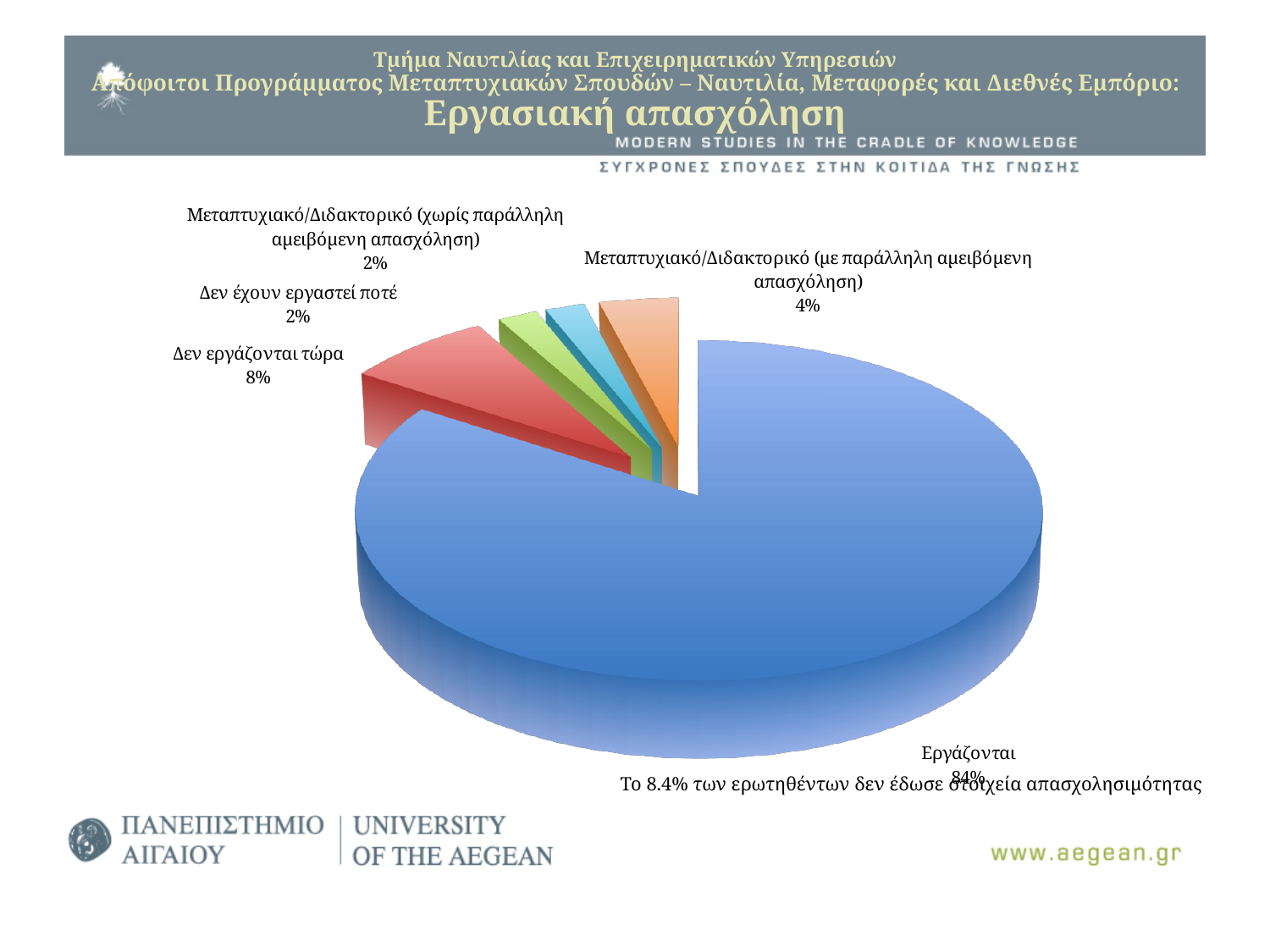
What is the difference in percentage points between "Μεταπτυχιακό/Διδακτορικό (με παράλληλη αμειβόμενη απασχόληση)" and "Δεν έχουν εργαστεί ποτέ"? 2 What colour is the slice for "Εργάζονται"? Blue What percentage of graduates are shown as "Εργάζονται"? 84% How many slices does the pie chart have? 5 Which category has the largest share of the pie? Εργάζονται Which is larger: "Δεν εργάζονται τώρα" or "Μεταπτυχιακό/Διδακτορικό (με παράλληλη αμειβόμενη απασχόληση)"? Δεν εργάζονται τώρα What is the value for "Δεν έχουν εργαστεί ποτέ"? 2% What is the difference in percentage points between "Εργάζονται" and "Δεν εργάζονται τώρα"? 76 What kind of chart is shown on the slide? Pie chart What is the value for "Μεταπτυχιακό/Διδακτορικό (χωρίς παράλληλη αμειβόμενη απασχόληση)"? 2% What is the value for "Δεν εργάζονται τώρα"? 8% What is the value for "Μεταπτυχιακό/Διδακτορικό (με παράλληλη αμειβόμενη απασχόληση)"? 4%